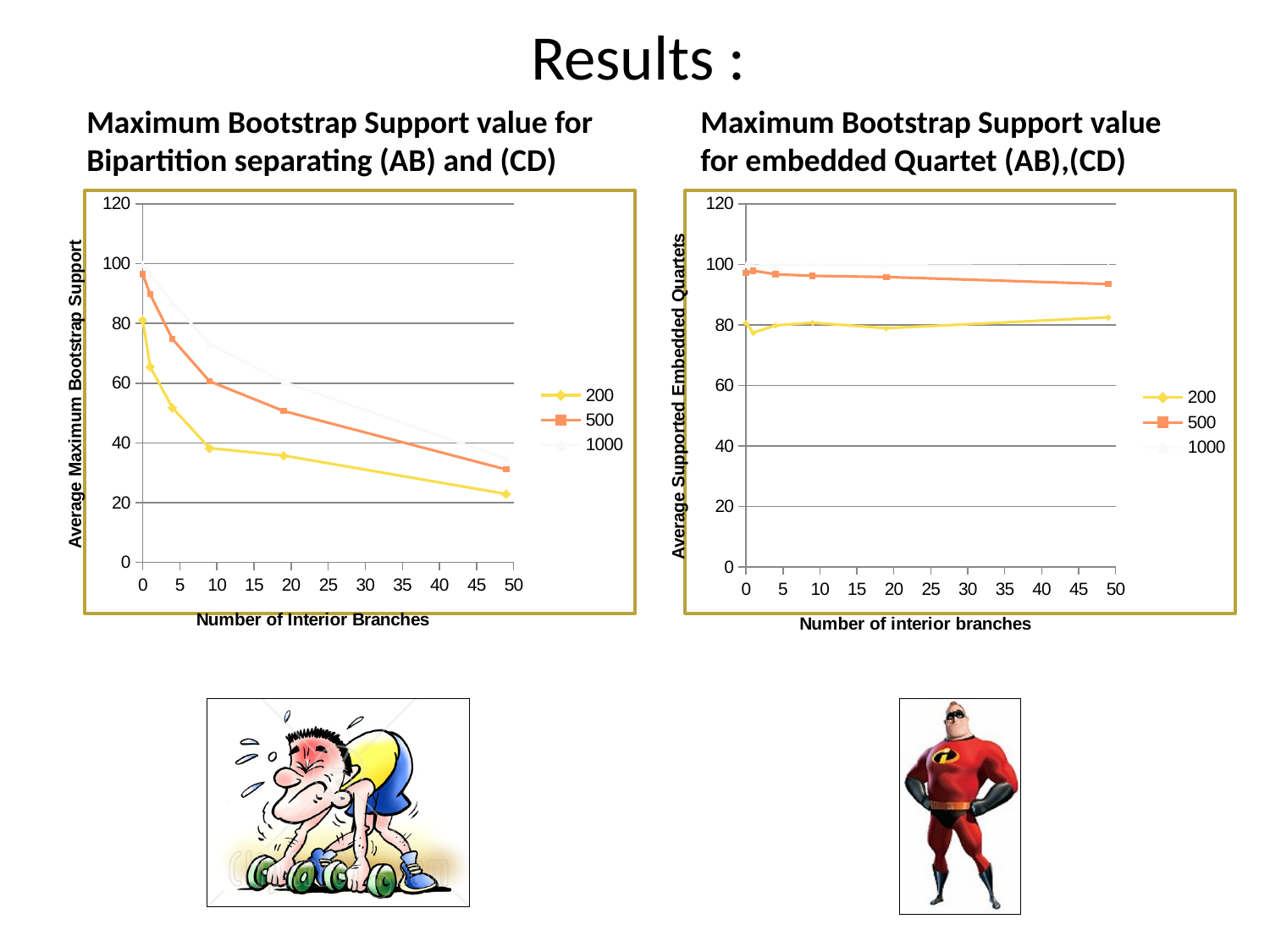
In the left chart, does the 200 series rise or fall as the number of interior branches increases? fall What is the y-axis title of the right chart? Average Supported Embedded Quartets In the left chart, is the value of the 500 series at 0 interior branches greater or less than 80? greater What kind of chart is the right chart, 'Maximum Bootstrap Support value for embedded Quartet (AB),(CD)'? line chart How many series does the legend of the left chart list? 3 How many series does the legend of the right chart list? 3 What kind of chart is the left chart, 'Maximum Bootstrap Support value for Bipartition separating (AB) and (CD)'? line chart In the right chart, at 20 interior branches, which series has the larger value, 200 or 500? 500 In the left chart, at 50 interior branches, which series has the larger value, 200 or 500? 500 In the right chart, is the value of the 500 series at 50 interior branches greater or less than 80? greater In the left chart, is the value of the 200 series at 50 interior branches greater or less than 40? less In the left chart, does the 500 series rise or fall as the number of interior branches increases? fall